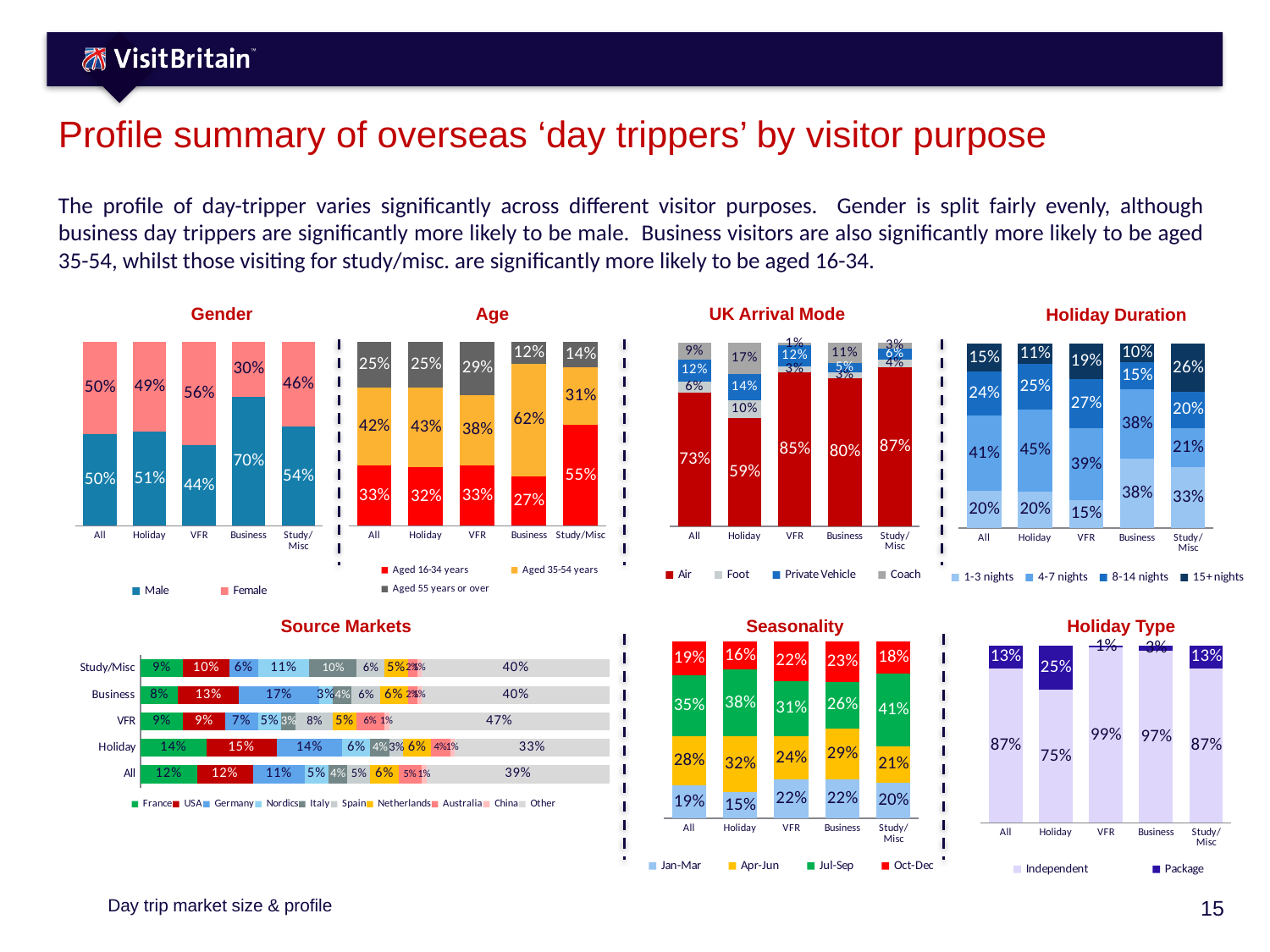
In the Holiday Type chart, what percentage of Holiday visitors travel on a Package? 25% In the Gender chart, what percentage of Business day trippers are male? 70% In the UK Arrival Mode chart, what is the difference between the Air share for Study/Misc and for Holiday? 28 percentage points In the Source Markets chart, what is the 'Other' share for VFR visitors? 47% In the Age chart, what percentage of Study/Misc visitors are aged 16-34 years? 55% In the UK Arrival Mode chart, what percentage of Holiday visitors arrive by Air? 59% In the Seasonality chart, which visitor purpose has the highest Jul-Sep share? Study/Misc In the Gender chart, which visitor purpose has the highest share of female visitors? VFR In the Age chart, which visitor purpose has the highest share aged 35-54 years? Business In the Age chart, how many series does the legend list? 3 In the Holiday Duration chart, which visitor purpose has the lowest share staying 1-3 nights? VFR In the Holiday Duration chart, what percentage of Business visitors stay 1-3 nights? 38%